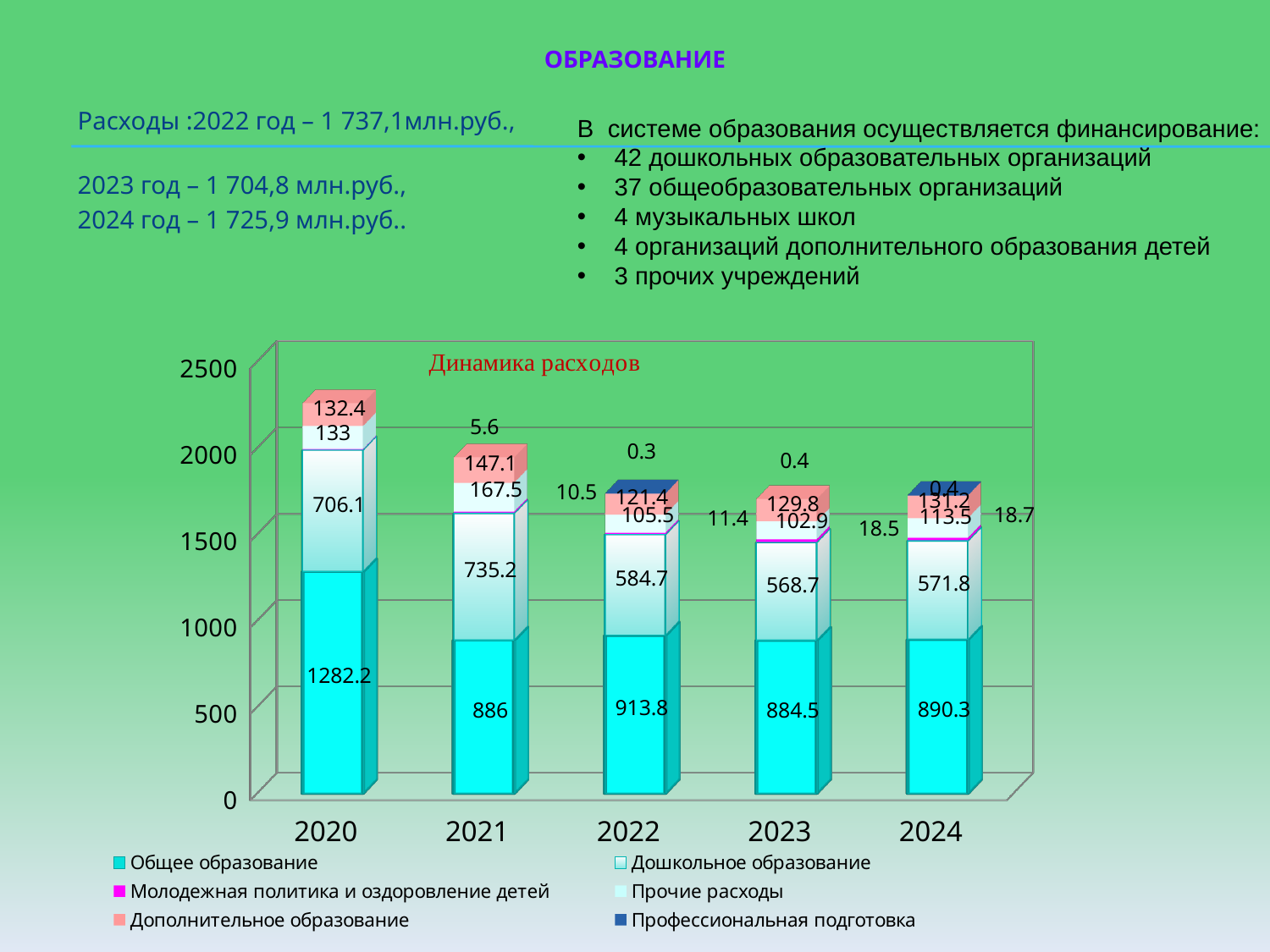
In which year is the value for Дошкольное образование the lowest? 2023 How many series does the legend list? 6 Which is larger, the Дошкольное образование value for 2021 or for 2022? 2021 In which year is the value for Общее образование the highest? 2020 What is the difference between the Общее образование values for 2020 and 2021? 396.2 Is the total height of the stacked bar for 2020 greater or less than 2000? greater What is the value for Общее образование in 2024? 890.3 How many years are shown on the x axis? 5 What is the value for Дополнительное образование in 2023? 129.8 What is the title of the chart? Динамика расходов What is the value for Дошкольное образование in 2021? 735.2 What is the value for Общее образование in 2020? 1282.2